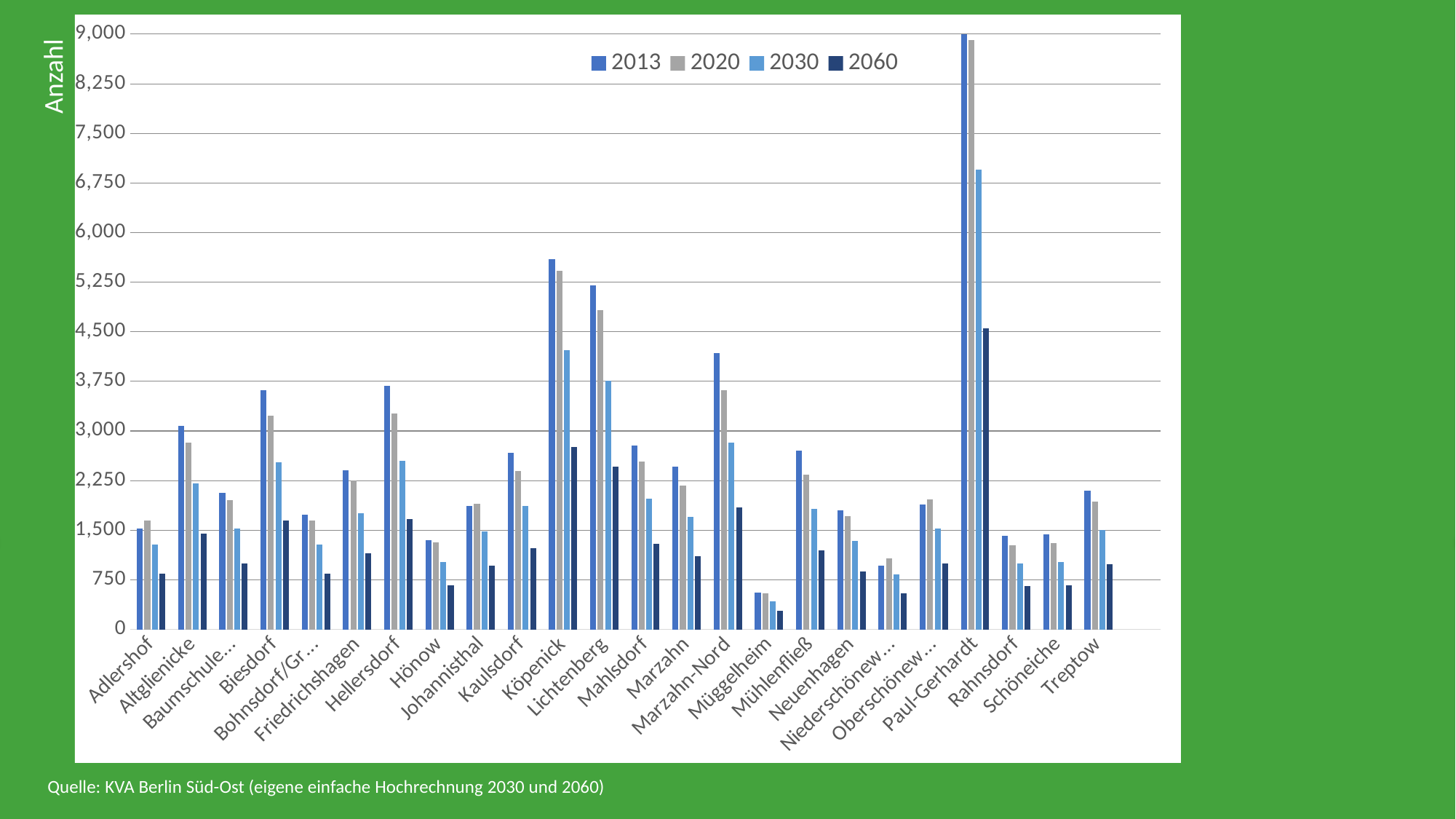
Is the value for Paul-Gerhardt in 2030 greater or less than 6,750? greater Which category has the lowest value for 2013? Müggelheim Is the value for Müggelheim in 2013 greater or less than 750? less For Köpenick, do the values rise or fall from 2013 through 2060? fall How many categories are shown along the x axis? 24 How many series does the legend list? 4 What kind of chart is shown on the slide? bar chart Which is larger: the 2013 value for Köpenick or the 2013 value for Lichtenberg? Köpenick Which category has the highest value for 2013? Paul-Gerhardt Is the value for Köpenick in 2013 greater or less than 5,250? greater What is the label on the vertical axis? Anzahl